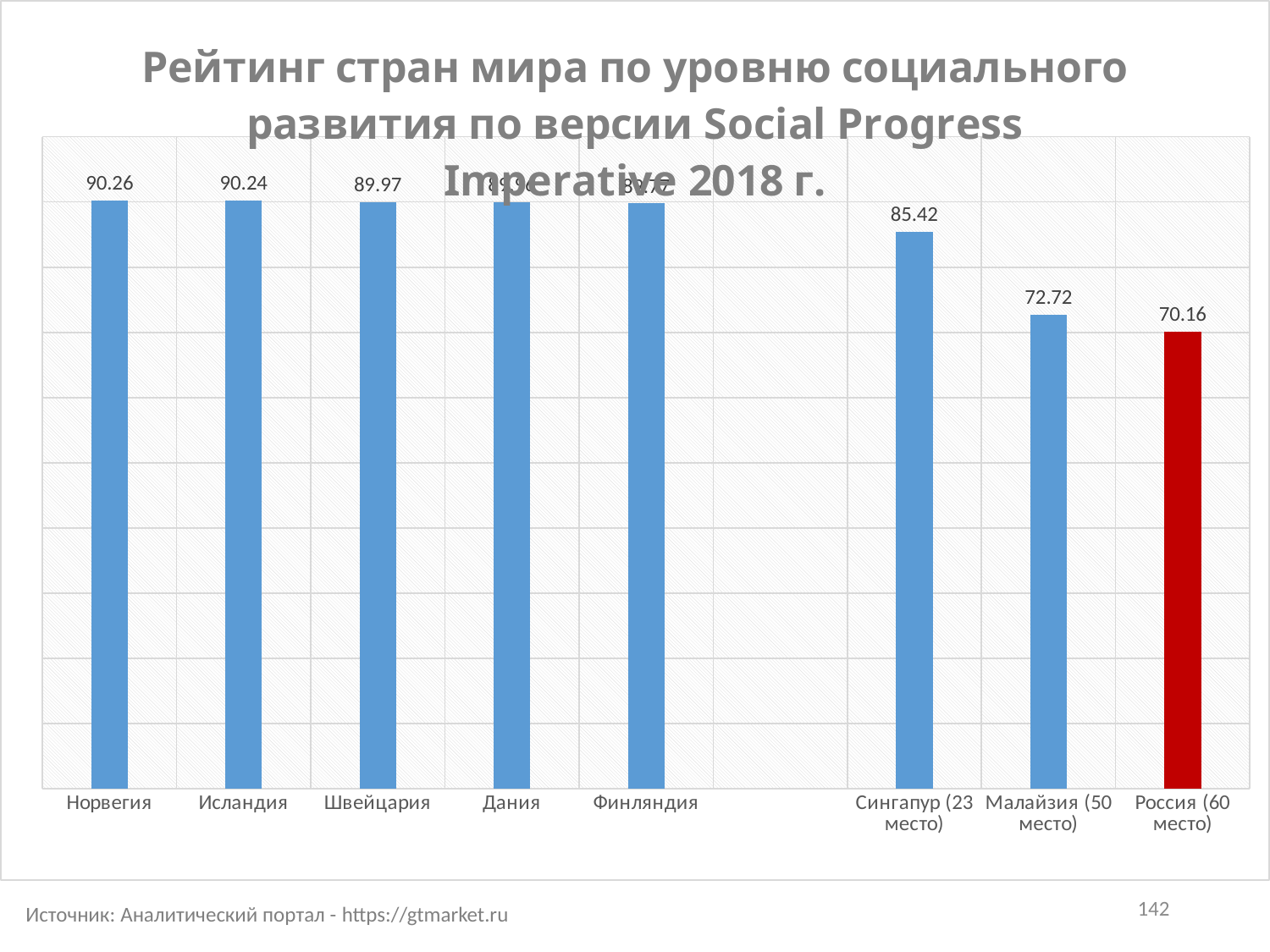
Which country has the highest value on the chart? Норвегия What is the value for Швейцария? 89.97 What is the difference between the values for Сингапур (23 место) and Россия (60 место)? 15.26 What is the value for Норвегия? 90.26 How many countries are shown on the chart? 8 What is the value for Россия (60 место)? 70.16 Which country has the lowest value on the chart? Россия (60 место) What is the value for Малайзия (50 место)? 72.72 What is the value for Сингапур (23 место)? 85.42 Which is larger, the value for Сингапур (23 место) or the value for Малайзия (50 место)? Сингапур (23 место) What kind of chart is shown on the slide? Bar chart What is the difference between the values for Малайзия (50 место) and Россия (60 место)? 2.56